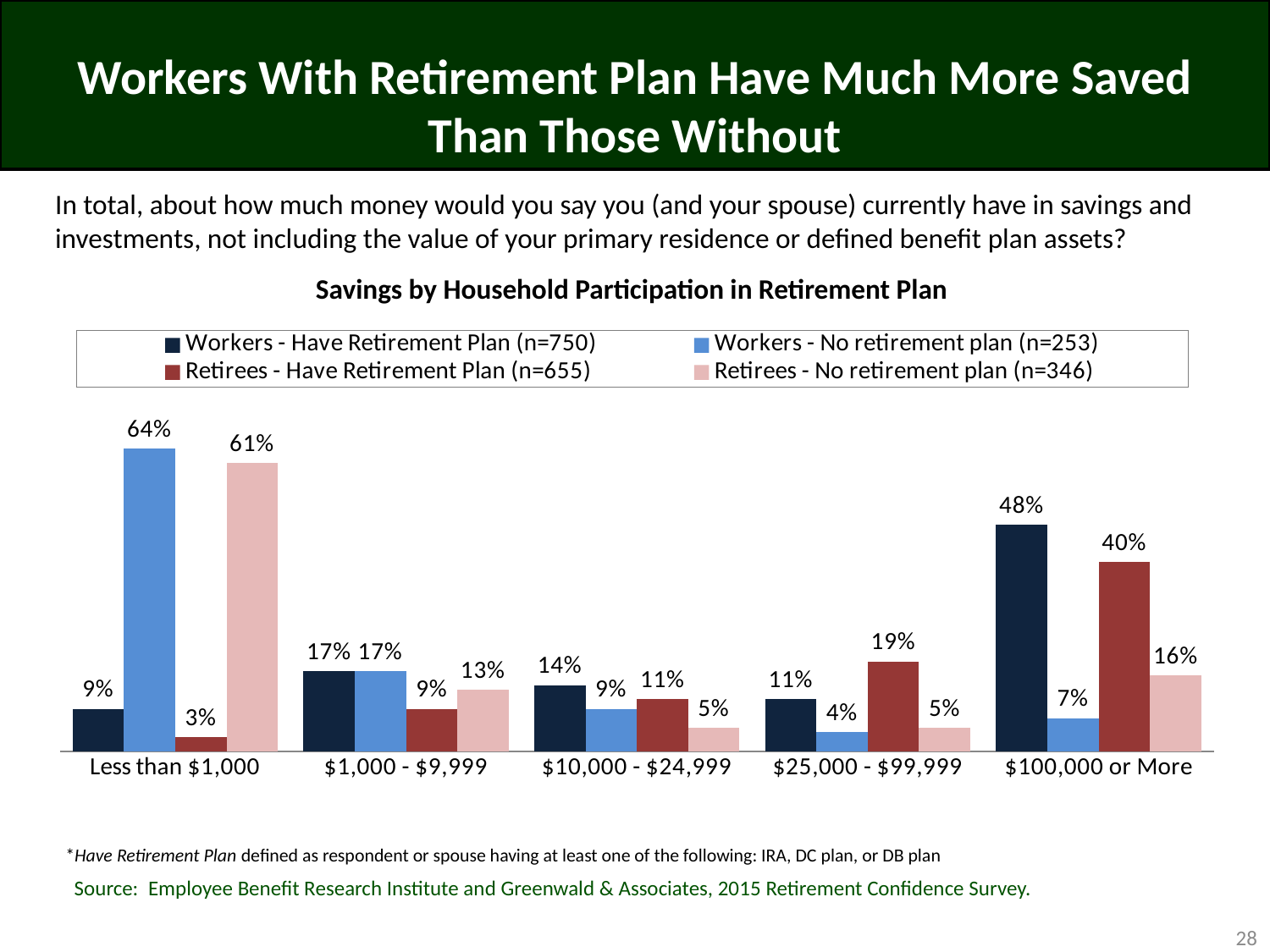
Which savings category has the lowest value for Workers - No retirement plan? $25,000 - $99,999 What percentage of Workers - Have Retirement Plan have $100,000 or more in savings? 48% What is the title of the chart? Savings by Household Participation in Retirement Plan What is the difference between Workers - Have Retirement Plan and Retirees - Have Retirement Plan in the $100,000 or More category? 8% What percentage of Retirees - Have Retirement Plan have $25,000 - $99,999 in savings? 19% In the $10,000 - $24,999 category, which is larger: Workers - Have Retirement Plan or Retirees - No retirement plan? Workers - Have Retirement Plan What percentage of Workers - No retirement plan have less than $1,000 in savings? 64% How many savings categories are shown on the x axis? 5 How many series does the legend list? 4 Which savings category has the highest value for Retirees - No retirement plan? Less than $1,000 What type of chart is shown on the slide? Bar chart What is the sample size (n) for the Retirees - Have Retirement Plan series shown in the legend? 655